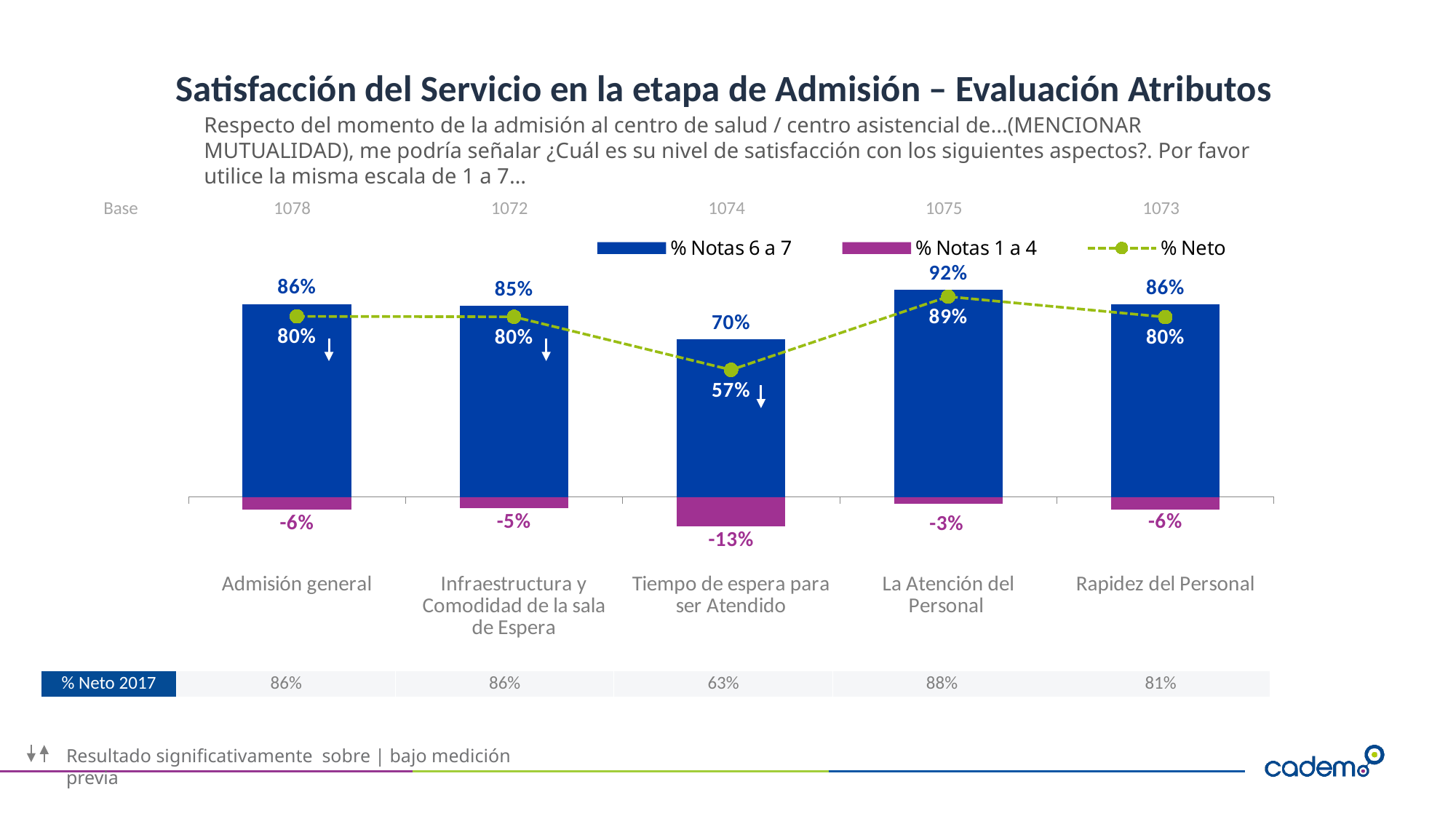
What colour are the % Notas 1 a 4 bars? Purple What kind of chart is shown on the slide? Bar chart with a line How many series does the legend list? 3 Which category has the lowest % Neto value? Tiempo de espera para ser Atendido How many categories are shown on the x axis of the chart? 5 What is the difference between the % Notas 6 a 7 values for La Atención del Personal and Tiempo de espera para ser Atendido? 22% What is the % Neto value for Infraestructura y Comodidad de la sala de Espera? 80% Which is larger, the % Neto value for Admisión general or for La Atención del Personal? La Atención del Personal What is the % Notas 1 a 4 value for Tiempo de espera para ser Atendido? -13% What is the % Neto 2017 value shown for Tiempo de espera para ser Atendido? 63% Which category has the highest % Notas 6 a 7 value? La Atención del Personal What is the % Notas 6 a 7 value for La Atención del Personal? 92%